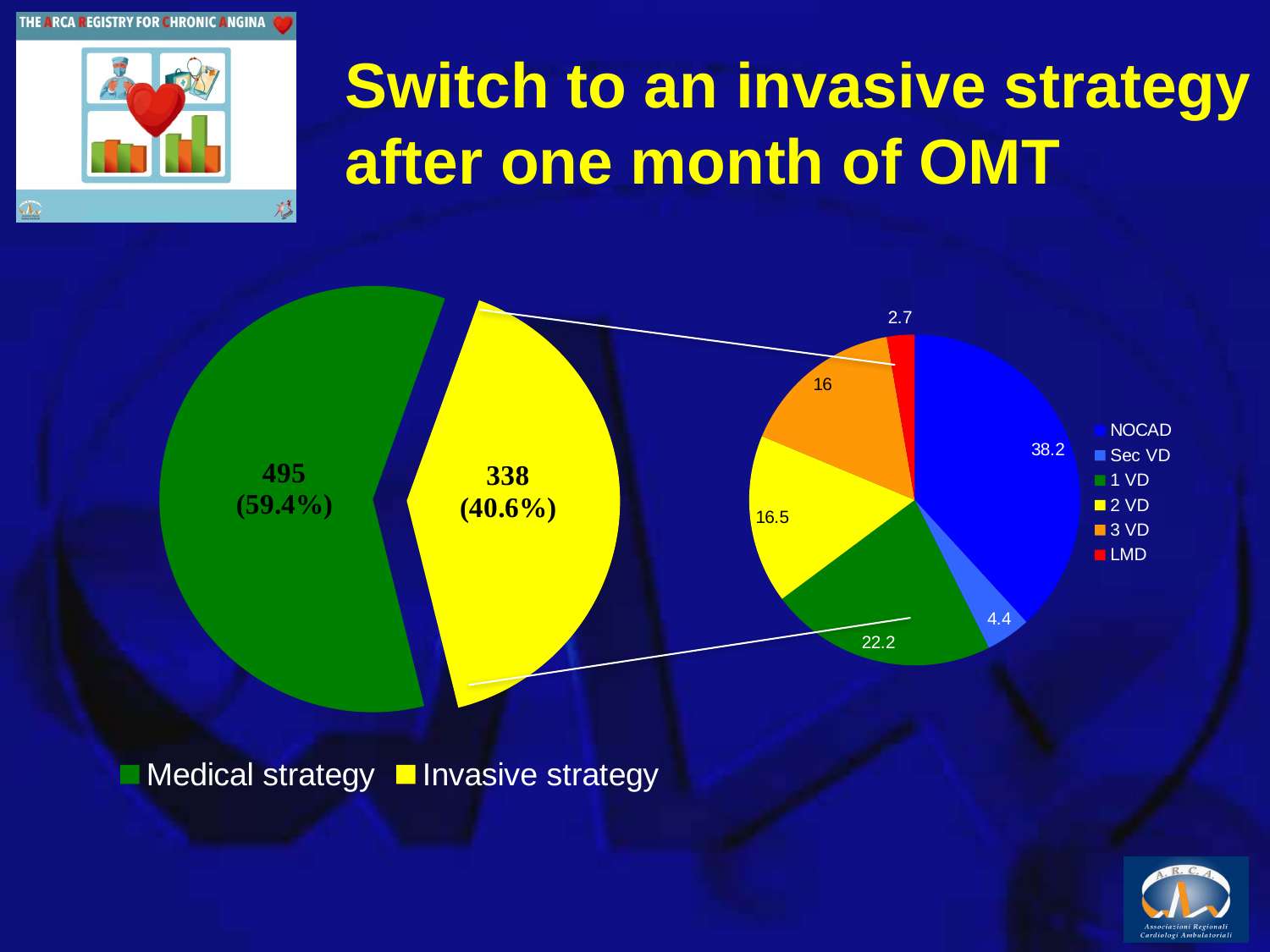
On the left pie chart, what share of the pie does Invasive strategy represent? 40.6% On the right pie chart, what is the value shown for NOCAD? 38.2 On the right pie chart, what is the value shown for 1 VD? 22.2 On the right pie chart, which category has the smallest value? LMD On the left pie chart, what is the difference between the Medical strategy count and the Invasive strategy count? 157 On the left pie chart, which category is larger, Medical strategy or Invasive strategy? Medical strategy On the left pie chart, what is the value shown for Medical strategy? 495 (59.4%) On the right pie chart, how many categories are shown? 6 On the left pie chart, how many categories does the legend list? 2 On the left pie chart, what is the value shown for Invasive strategy? 338 (40.6%) On the right pie chart, which category has the largest value? NOCAD What type of chart is used on the left side of the slide? Pie chart